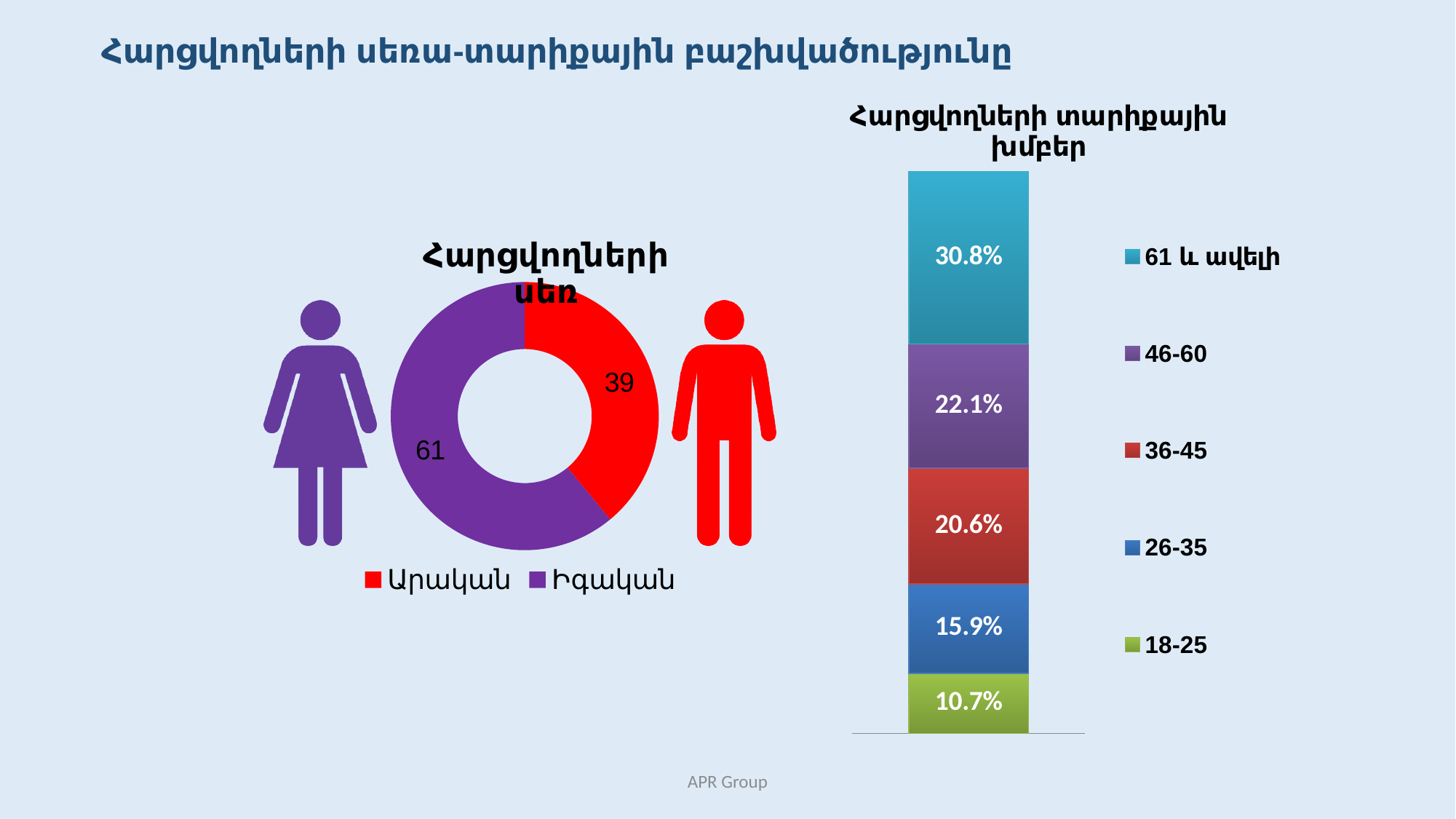
In the donut chart on the left (Հարցվողների սեռ), what is the value for Իգական? 61 In the stacked bar chart on the right (Հարցվողների տարիքային խմբեր), which age group has the largest share? 61 և ավելի How many age groups does the legend of the stacked bar chart on the right (Հարցվողների տարիքային խմբեր) list? 5 In the donut chart on the left (Հարցվողների սեռ), what is the value for Արական? 39 In the donut chart on the left (Հարցվողների սեռ), which category has the larger value, Արական or Իգական? Իգական In the donut chart on the left (Հարցվողների սեռ), what is the difference between the values for Իգական and Արական? 22 In the stacked bar chart on the right (Հարցվողների տարիքային խմբեր), what is the value for the 61 և ավելի group? 30.8% What type of chart is the chart on the right (Հարցվողների տարիքային խմբեր)? Stacked bar chart How many series does the legend of the donut chart on the left (Հարցվողների սեռ) list? 2 In the stacked bar chart on the right (Հարցվողների տարիքային խմբեր), what is the difference between the 46-60 and 36-45 groups? 1.5% In the stacked bar chart on the right (Հարցվողների տարիքային խմբեր), which age group has the smallest share? 18-25 In the stacked bar chart on the right (Հարցվողների տարիքային խմբեր), what is the value for the 26-35 group? 15.9%